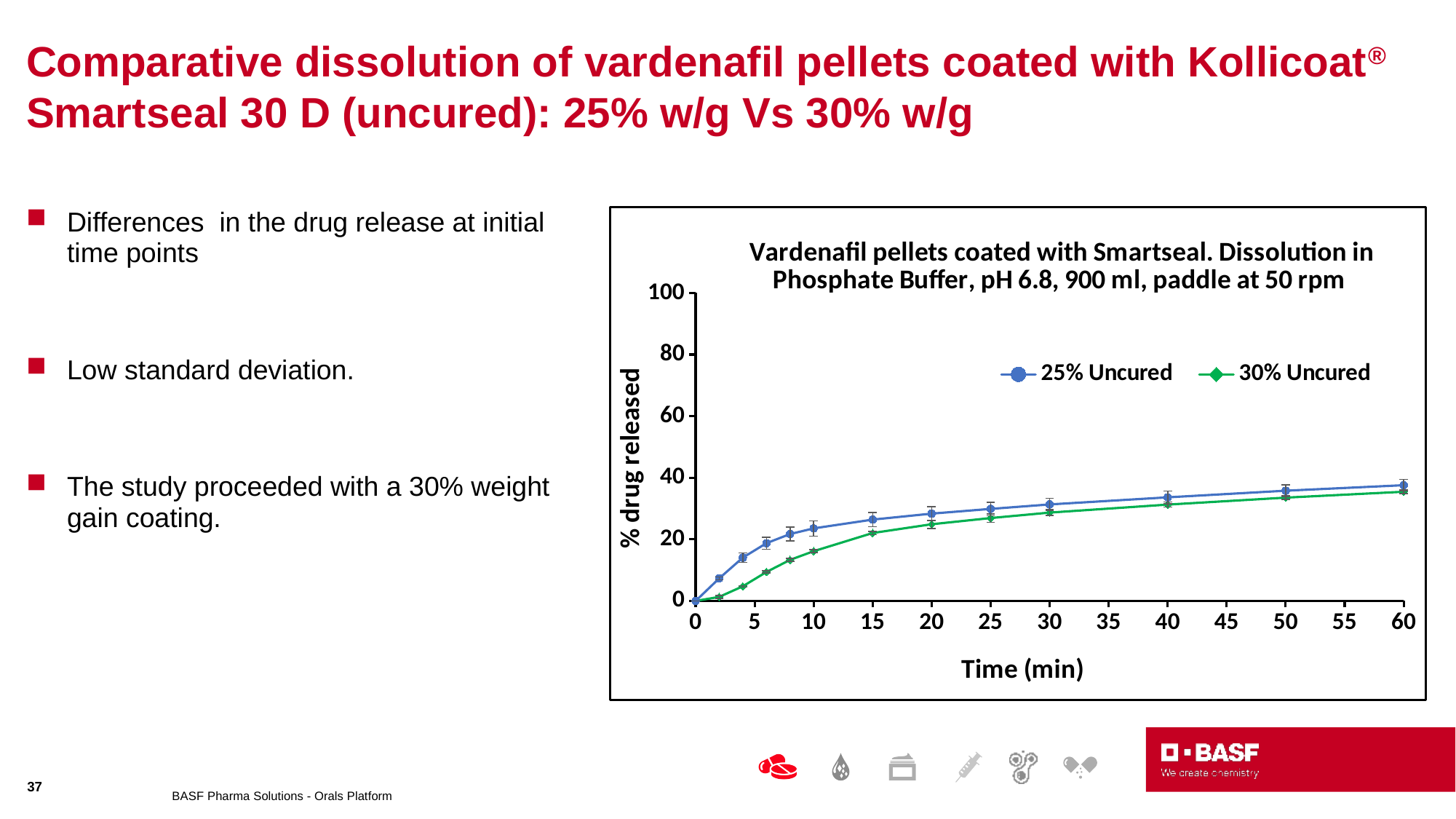
Is the value for 25% Uncured at 4 min greater or less than 20? less Which series is plotted in green? 30% Uncured Is the value for 25% Uncured at 10 min greater or less than 20? greater What is the label of the y axis? % drug released What kind of chart is shown on the slide? line chart At 10 min, which series has the higher % drug released, 25% Uncured or 30% Uncured? 25% Uncured Is the value for 30% Uncured at 20 min greater or less than 20? greater Does the % drug released for 30% Uncured rise or fall as time increases? rise At which time point does the 25% Uncured series reach its highest value? 60 How many series does the chart legend list? 2